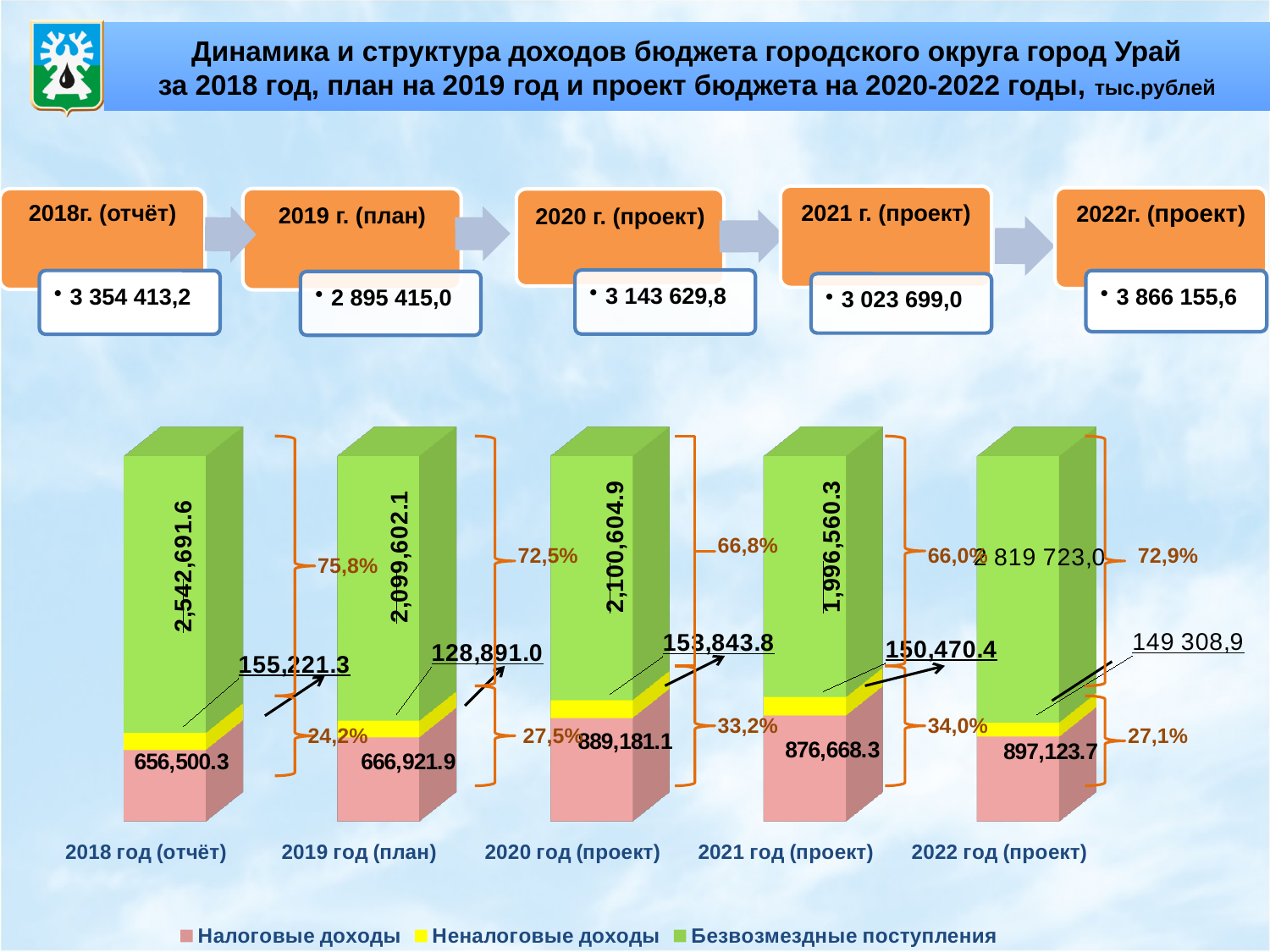
Which colour represents Неналоговые доходы in the chart? Yellow How many years (categories) are shown on the x axis of the chart? 5 What is the value of Налоговые доходы for 2020 год (проект)? 889,181.1 How many series does the chart legend list? 3 What is the value of Налоговые доходы for 2022 год (проект)? 897,123.7 What is the value of Неналоговые доходы for 2019 год (план)? 128,891.0 In which year is the value of Безвозмездные поступления the highest? 2022 год (проект) What is the difference between Налоговые доходы in 2022 год (проект) and 2021 год (проект)? 20,455.4 What is the value of Безвозмездные поступления for 2018 год (отчёт)? 2,542,691.6 What type of chart is shown on the slide? Stacked bar chart Which is larger: Неналоговые доходы in 2018 год (отчёт) or in 2020 год (проект)? 2018 год (отчёт) In which year is the value of Безвозмездные поступления the lowest? 2021 год (проект)